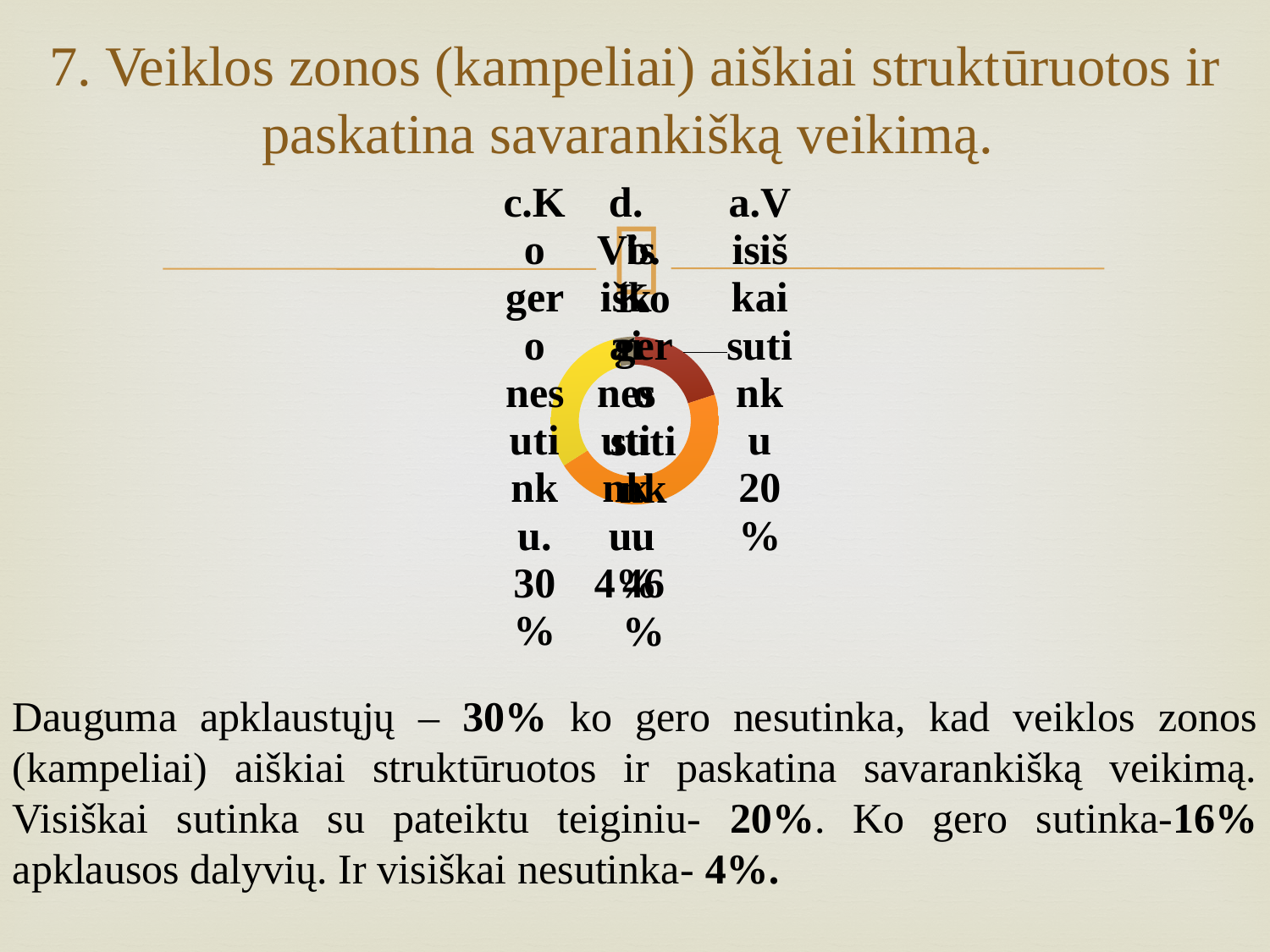
What percentage is shown for "b. Ko gero sutinku"? 46% How many response categories are shown in the chart? 4 What percentage is shown for "a. Visiškai sutinku"? 20% What kind of chart is shown on the slide? Doughnut (pie) chart What is the difference between the percentages for "Ko gero nesutinku" and "Visiškai sutinku"? 10 percentage points What is the difference between the percentages for "Ko gero sutinku" and "Visiškai nesutinku"? 42 percentage points Which response category has the lowest percentage? d. Visiškai nesutinku (4%) What percentage is shown for "c. Ko gero nesutinku"? 30% What percentage is shown for "d. Visiškai nesutinku"? 4% Which is larger: the percentage for "Visiškai sutinku" or for "Ko gero sutinku"? Ko gero sutinku (46%) Which response category has the highest percentage? b. Ko gero sutinku (46%)